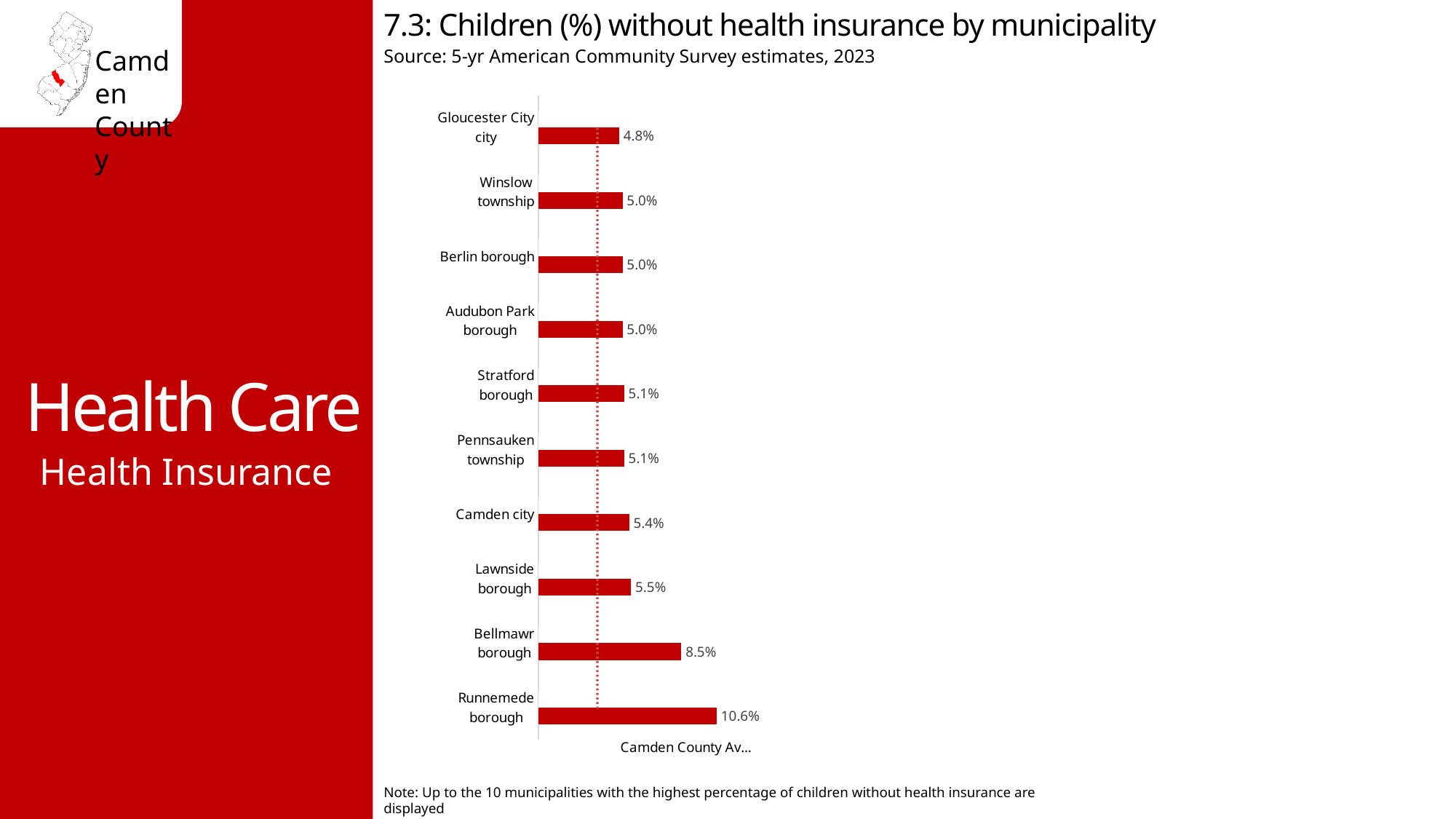
What is the difference between the values for Lawnside borough and Gloucester City city? 0.7% How many municipalities are shown in the chart? 10 What percentage is shown for Camden city? 5.4% Which municipality has the highest percentage of children without health insurance? Runnemede borough What is the value shown for Bellmawr borough? 8.5% What is the title of the chart? 7.3: Children (%) without health insurance by municipality What is the value for Gloucester City city? 4.8% Which has a higher value, Bellmawr borough or Camden city? Bellmawr borough Which municipality has the lowest percentage of children without health insurance? Gloucester City city What type of chart is shown on the slide? Bar chart What percentage of children are without health insurance in Runnemede borough? 10.6% What is the difference between the values for Runnemede borough and Bellmawr borough? 2.1%